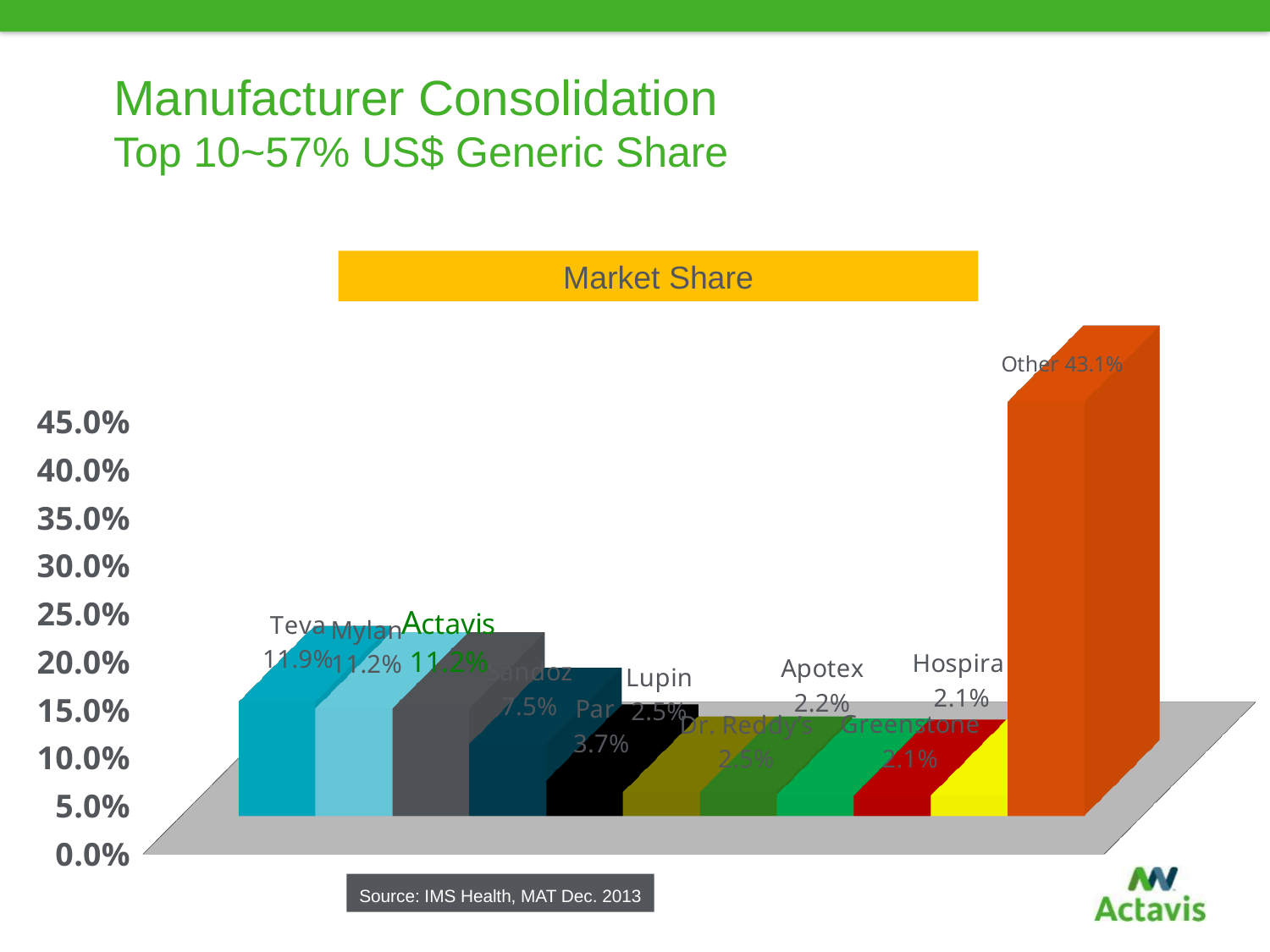
What is the market share value for Teva? 11.9% What is the market share value for Par? 3.7% Which has a larger market share, Sandoz or Lupin? Sandoz What is the market share value for Hospira? 2.1% What is the difference between the market share of Teva and Mylan? 0.7% What is the title of the chart? Market Share How many categories (bars) are shown in the chart? 11 What type of chart is shown on the slide? bar chart What is the difference between the market share of Other and Teva? 31.2% What is the market share value for Apotex? 2.2% Which category has the highest market share? Other What is the market share value for Other? 43.1%